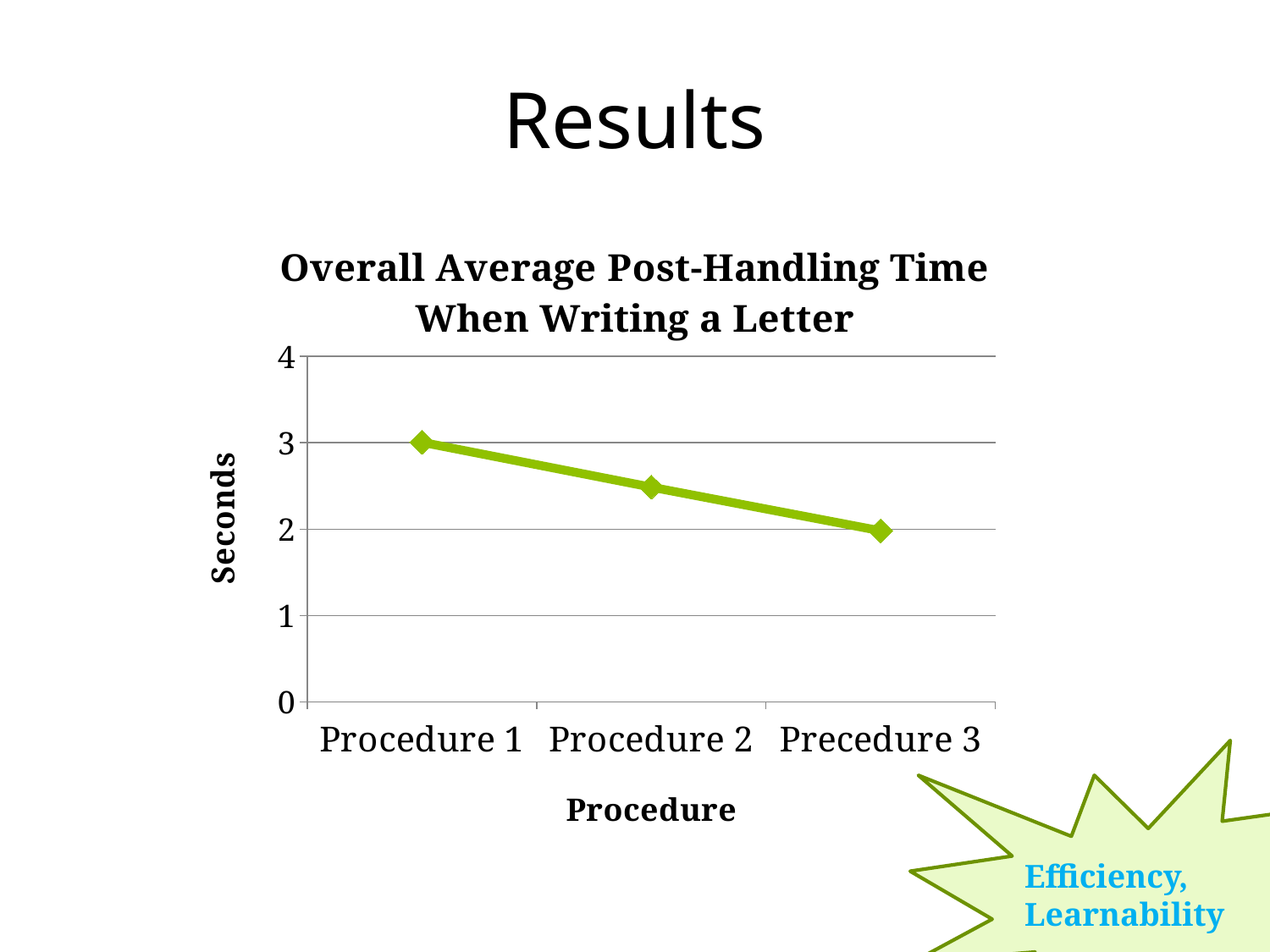
Do the values rise or fall from Procedure 1 to Precedure 3? fall Which procedure has the lowest average post-handling time? Precedure 3 What kind of chart is shown on the slide? line chart What is the label on the vertical axis of the chart? Seconds How many procedures are plotted on the x axis of the chart? 3 Is the value for Procedure 2 greater or less than 3? less Which has a higher value, Procedure 1 or Procedure 2? Procedure 1 Is the value for Procedure 2 greater or less than 2? greater Which procedure has the highest average post-handling time? Procedure 1